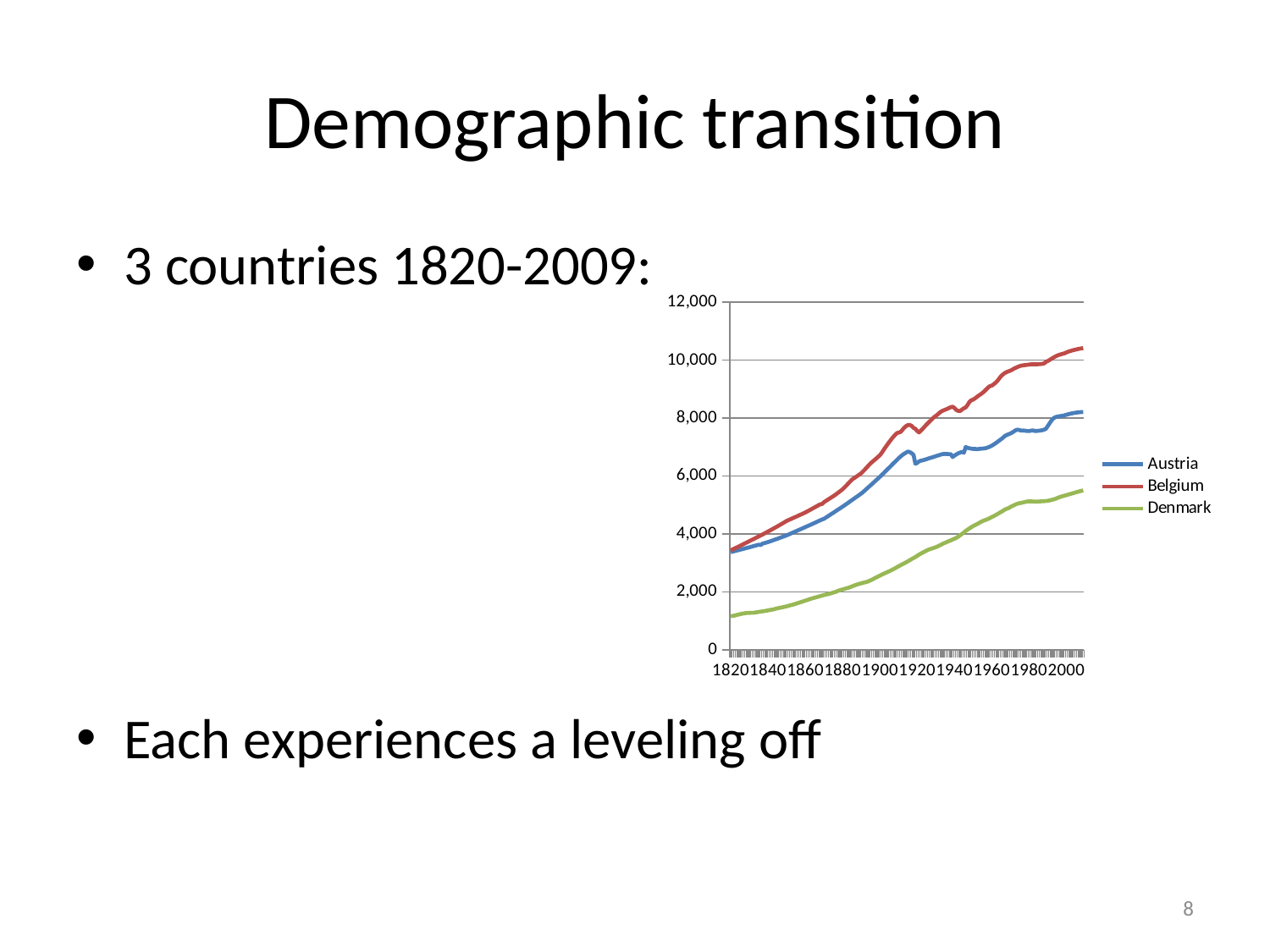
Do the values for Denmark rise or fall from 1820 to 2000? rise Which is larger in 1960, the value for Belgium or the value for Denmark? Belgium Is the value for Belgium in 1900 greater or less than 6,000? greater How many series does the chart's legend list? 3 Which countries are listed in the chart's legend? Austria, Belgium, Denmark What colour is the line for Belgium? red Which country has the lowest value throughout the chart? Denmark Is the value for Denmark at the right end of the chart greater or less than 6,000? less Which country has the highest value at the right end of the chart (around 2000)? Belgium What kind of chart is shown on the slide? line chart Is the value for Denmark in 1820 greater or less than 2,000? less